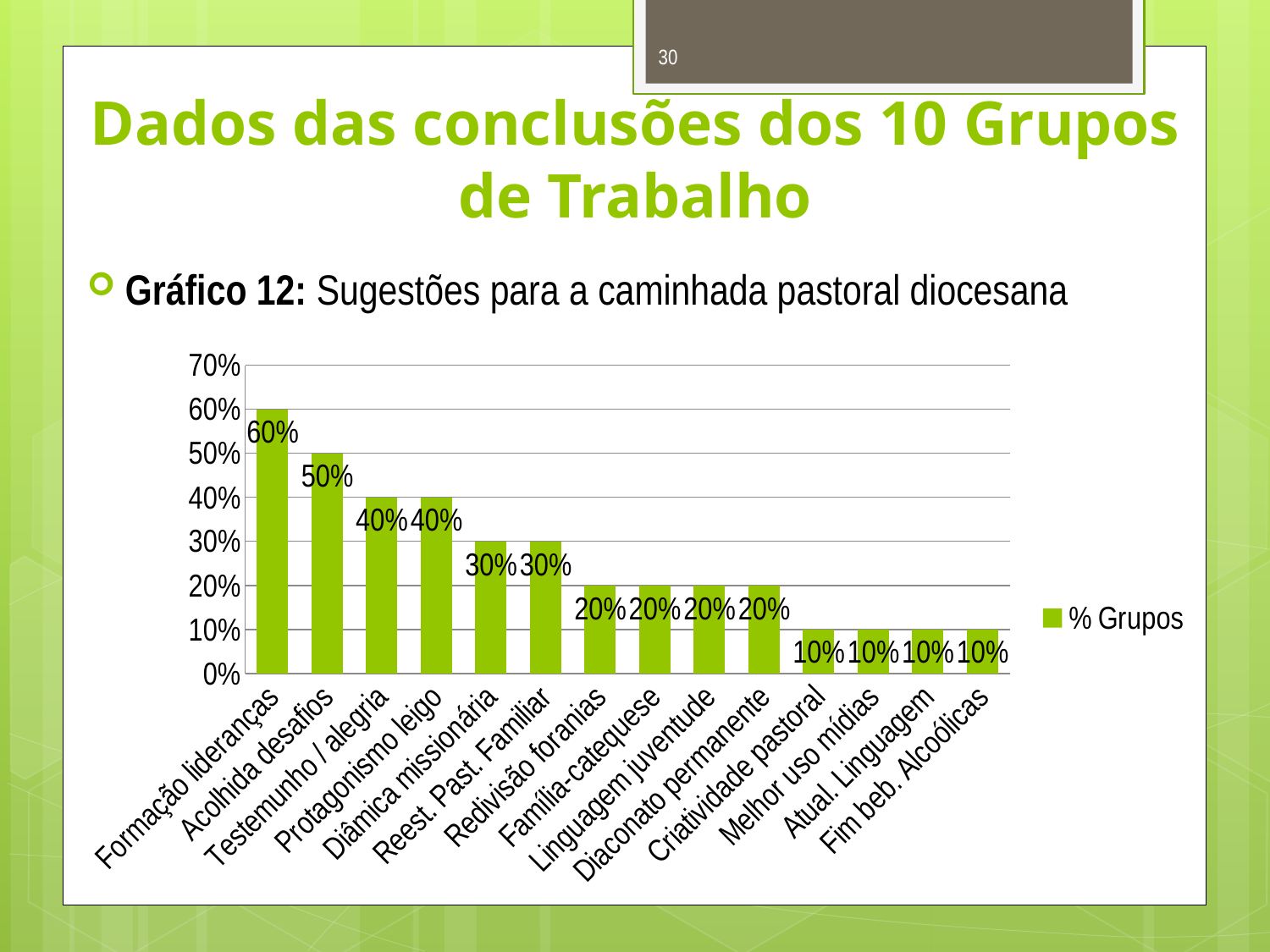
What is the difference between the values for Protagonismo leigo and Redivisão foranias? 20% How many categories are shown on the x axis? 14 Which category has the highest value? Formação lideranças What is the name of the series shown in the legend? % Grupos What is the value for Diaconato permanente? 20% Which is larger, the value for Testemunho / alegria or the value for Reest. Past. Familiar? Testemunho / alegria What is the value for Acolhida desafios? 50% What is the difference between the values for Formação lideranças and Acolhida desafios? 10% What kind of chart is shown? Bar chart How many series does the legend list? 1 What is the value for Melhor uso mídias? 10% What is the value for Formação lideranças? 60%